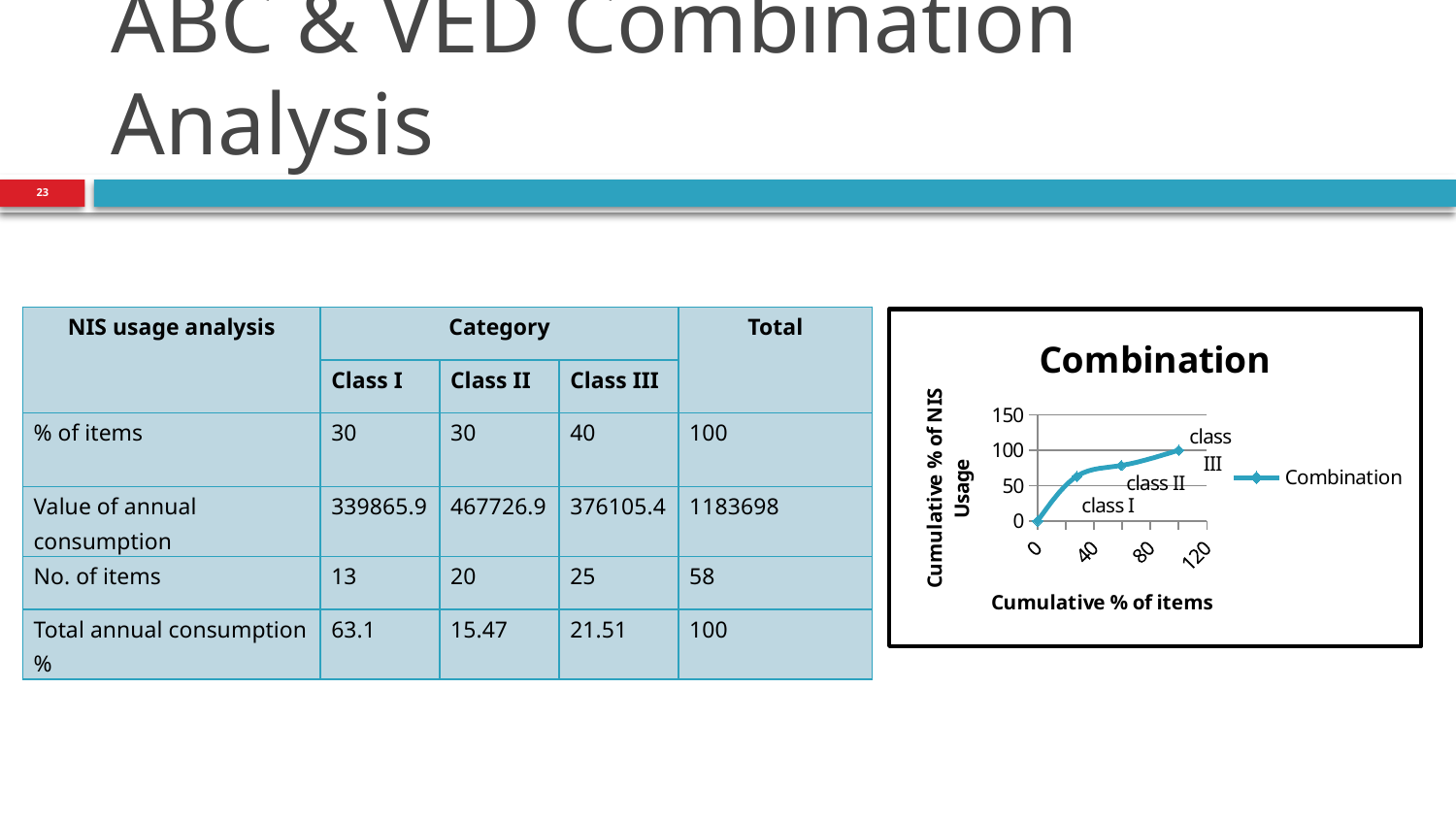
What is the legend entry shown on the "Combination" chart? Combination In the "Combination" chart, which labelled class point has the highest cumulative % of NIS usage? class III How many class labels are marked along the line in the "Combination" chart? 3 What kind of chart is the "Combination" chart? line chart In the "Combination" chart, is the cumulative % of NIS usage at the class I point greater or less than 50? greater In the "Combination" chart, which labelled class point has the lowest cumulative % of NIS usage? class I In the "Combination" chart, is the cumulative % of NIS usage at the class II point greater or less than 100? less What is the highest tick value shown on the y axis of the "Combination" chart? 150 Does the line in the "Combination" chart rise or fall as cumulative % of items increases? rises In the "Combination" chart, which point has a higher cumulative % of NIS usage, class I or class II? class II How many series does the legend of the "Combination" chart list? 1 What is the title of the x axis on the "Combination" chart? Cumulative % of items